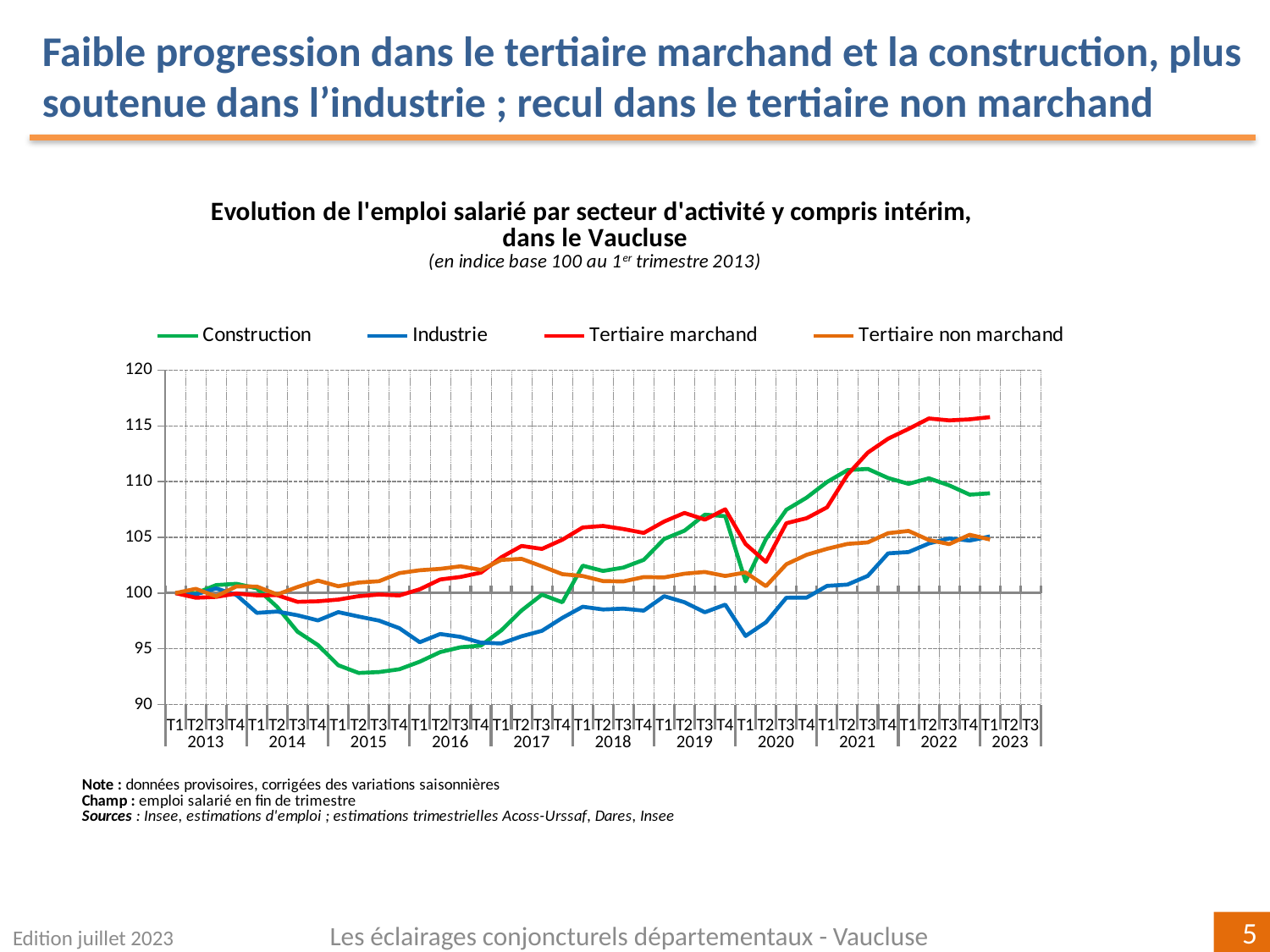
Is the value for Industrie at T1 2020 greater or less than 100? less Which series is the lowest at T2 2015? Construction What kind of chart is shown on the slide? line chart How many series does the legend list? 4 Is the value for Construction at T2 2015 greater or less than 95? less Which series is the lowest at T1 2020? Industrie Is the value for Tertiaire marchand at T1 2023 greater or less than 115? greater At T1 2020, which is higher: Construction or Industrie? Construction How many years are labelled on the x axis? 11 Which series is the highest at T1 2023? Tertiaire marchand Does the Tertiaire marchand series rise or fall overall from 2013 to 2023? rise What base value is the index set to, according to the chart subtitle? 100 au 1er trimestre 2013